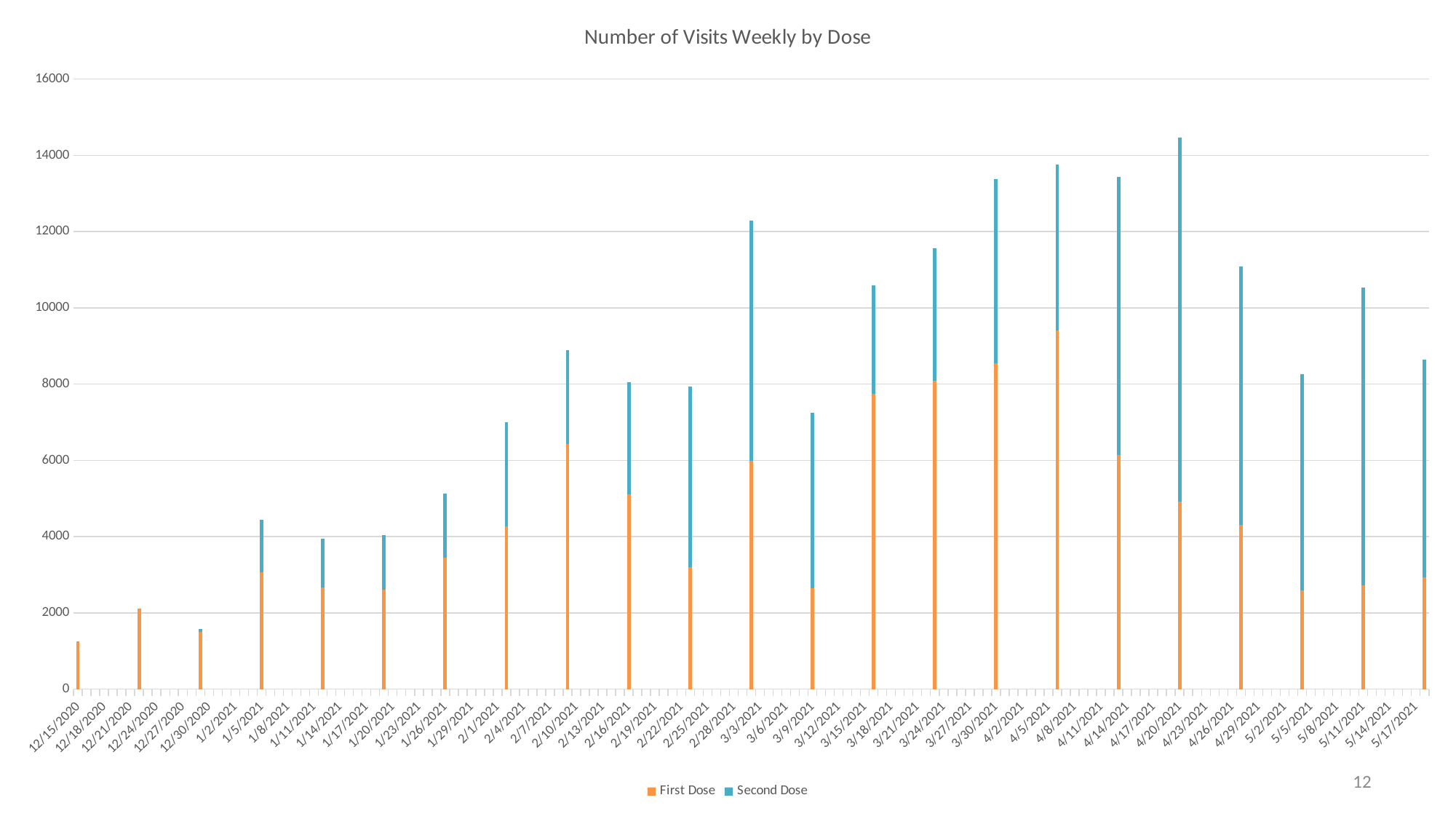
Is the total number of visits for 4/20/2021 greater or less than 14000? greater How many series does the legend list? 2 Which week has a higher total number of visits, 3/30/2021 or 3/9/2021? 3/30/2021 Is the total number of visits for 12/15/2020 greater or less than 2000? less Is the total number of visits for 3/30/2021 greater or less than 12000? greater What is the title of the chart? Number of Visits Weekly by Dose How many weekly bars are plotted in the chart? 23 Which week has the highest total number of visits? 4/20/2021 What type of chart is shown on the slide? Stacked bar chart Which week has the lowest total number of visits? 12/15/2020 Which colour represents the Second Dose series? Blue